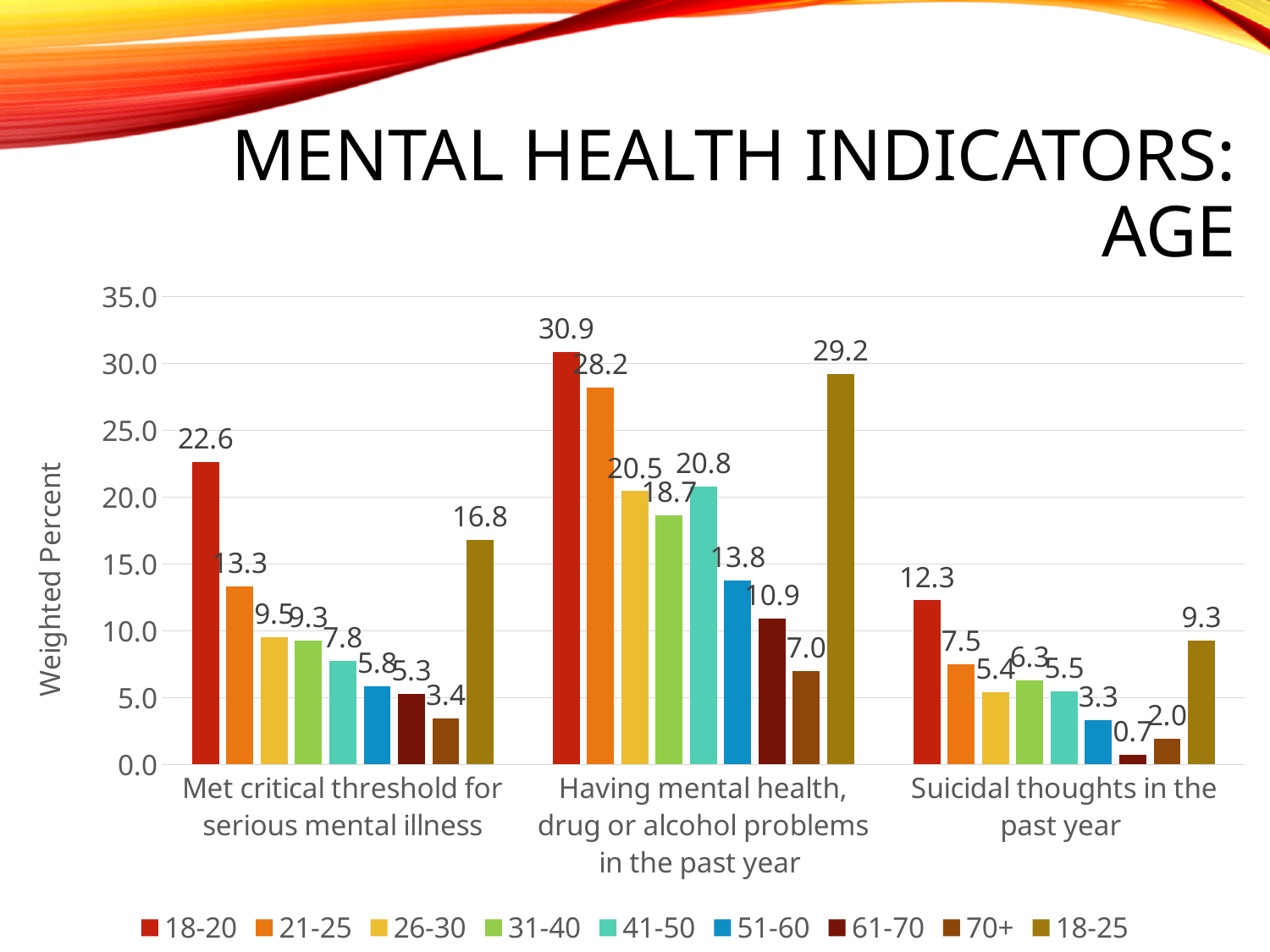
Under "Met critical threshold for serious mental illness", how much higher is the 18-20 value than the 21-25 value? 9.3 What is the title of the vertical axis? Weighted Percent Which age group has the highest value under "Having mental health, drug or alcohol problems in the past year"? 18-20 What is the value for the 61-70 age group under "Suicidal thoughts in the past year"? 0.7 How many age groups does the legend list? 9 What is the value for the 51-60 age group under "Having mental health, drug or alcohol problems in the past year"? 13.8 What is the value for the 18-25 age group under "Having mental health, drug or alcohol problems in the past year"? 29.2 Is the value for the 70+ age group under "Having mental health, drug or alcohol problems in the past year" greater or less than 10.0? less How many indicator categories are shown on the x axis? 3 Which age group has the lowest value under "Suicidal thoughts in the past year"? 61-70 What is the value for the 18-20 age group under "Met critical threshold for serious mental illness"? 22.6 Under "Having mental health, drug or alcohol problems in the past year", which is larger: the 41-50 value or the 31-40 value? 41-50